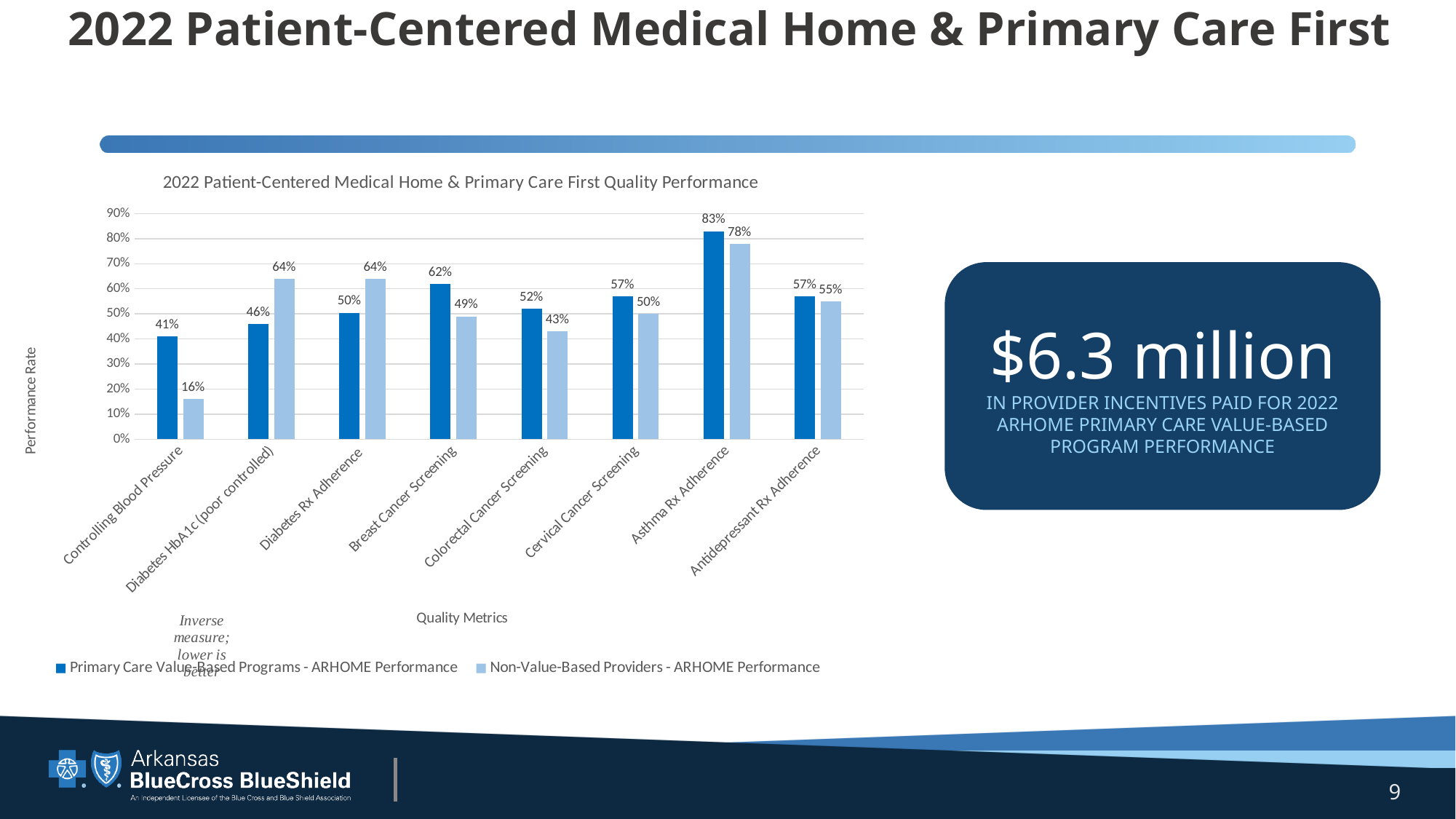
What is the Non-Value-Based Providers - ARHOME Performance value for Diabetes HbA1c (poor controlled)? 64% Which quality metric has the lowest Non-Value-Based Providers - ARHOME Performance value? Controlling Blood Pressure How many series does the legend list? 2 What is the Primary Care Value-Based Programs - ARHOME Performance value for Asthma Rx Adherence? 83% What is the title of the chart? 2022 Patient-Centered Medical Home & Primary Care First Quality Performance What is the difference between the Primary Care Value-Based Programs and Non-Value-Based Providers values for Controlling Blood Pressure? 25% What kind of chart is shown on the slide? Bar chart For Breast Cancer Screening, which series has the larger value: Primary Care Value-Based Programs or Non-Value-Based Providers? Primary Care Value-Based Programs - ARHOME Performance How many quality metrics are shown on the x axis? 8 What is the Primary Care Value-Based Programs - ARHOME Performance value for Controlling Blood Pressure? 41% Which quality metric has the highest Non-Value-Based Providers - ARHOME Performance value? Asthma Rx Adherence What is the label of the y axis? Performance Rate